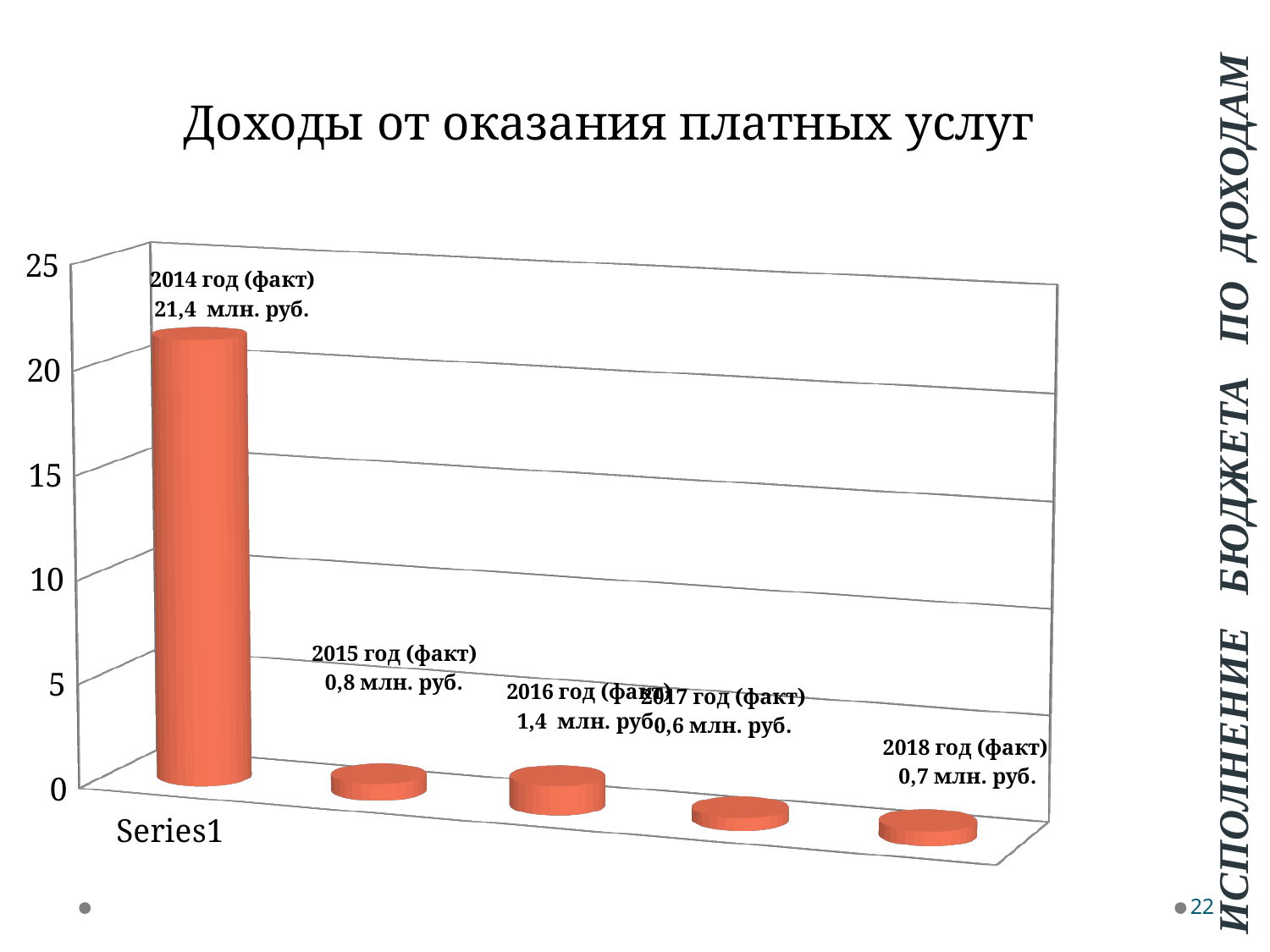
What is the value shown for 2018 год (факт)? 0,7 млн. руб. Which year has the lowest value in the chart? 2017 год (факт) What is the value shown for 2014 год (факт)? 21,4 млн. руб. What kind of chart is shown on the slide? bar chart How many bars are plotted in the chart? 5 What is the value shown for 2015 год (факт)? 0,8 млн. руб. Which is larger, the value for 2016 год (факт) or the value for 2015 год (факт)? 2016 год (факт) What is the value shown for 2016 год (факт)? 1,4 млн. руб. What is the title of the chart? Доходы от оказания платных услуг Is the value for 2014 год (факт) greater or less than 20? greater Which year has the highest value in the chart? 2014 год (факт) What is the difference between the values for 2014 год (факт) and 2015 год (факт)? 20,6 млн. руб.